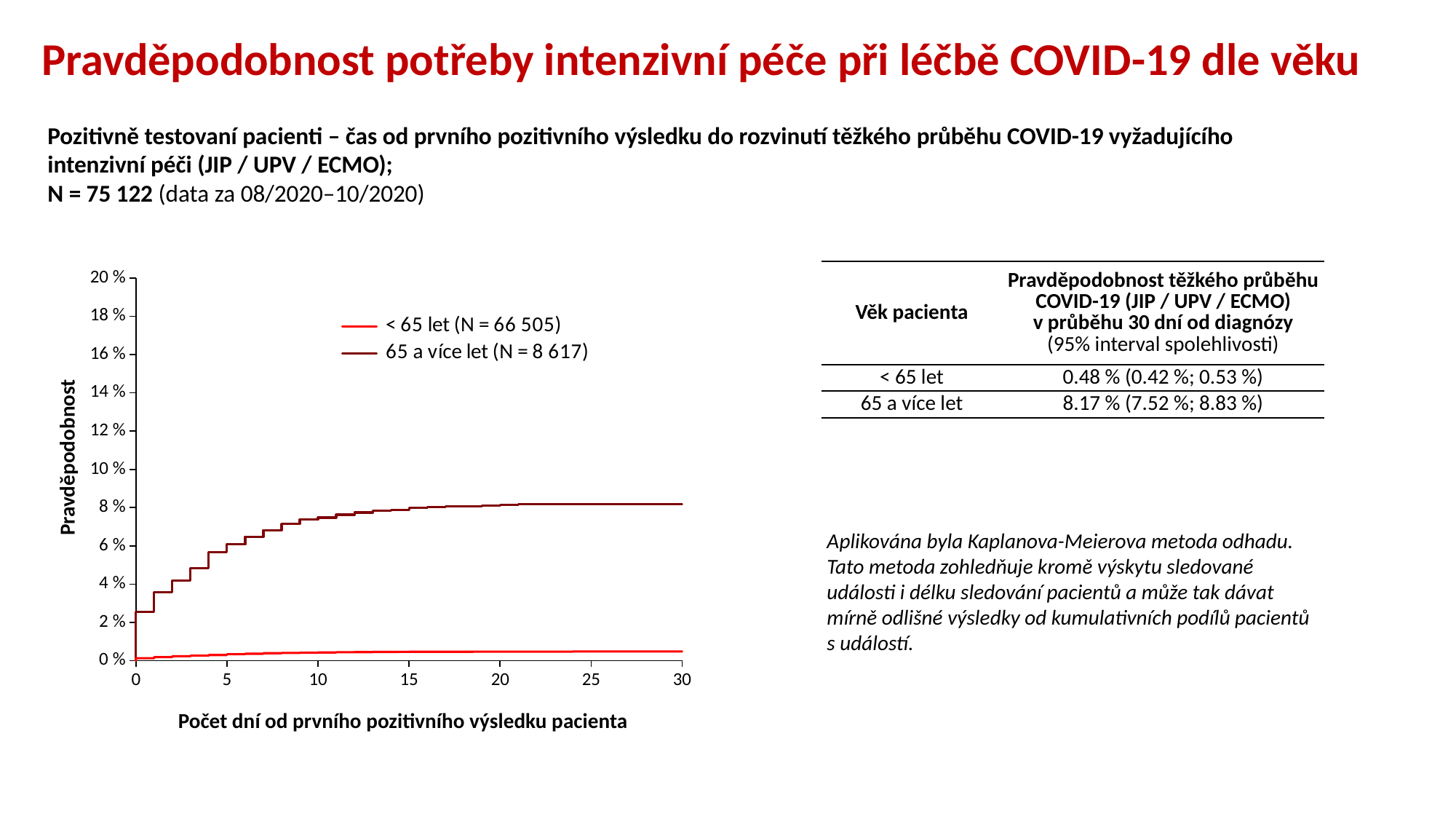
How many series does the chart legend list? 2 Which two groups are listed in the chart legend? < 65 let (N = 66 505) and 65 a více let (N = 8 617) Is the value for the < 65 let group at day 30 greater or less than 2 %? less Do the curves rise or fall as the number of days from the first positive result increases? rise What is the probability of severe COVID-19 course within 30 days of diagnosis for patients aged 65 and over? 8.17 % What is the difference between the 30-day probabilities for the 65 and over group and the under 65 group? 7.69 % Is the value for the 65 a více let group at day 5 greater or less than 8 %? less What is the probability of severe COVID-19 course within 30 days of diagnosis for patients under 65? 0.48 % What is the highest value shown on the y axis of the chart? 20 % What kind of chart is shown on the slide? line chart Which age group has the lower probability of severe COVID-19 course over the 30 days? < 65 let Which age group has the higher probability of severe COVID-19 course over the 30 days? 65 a více let